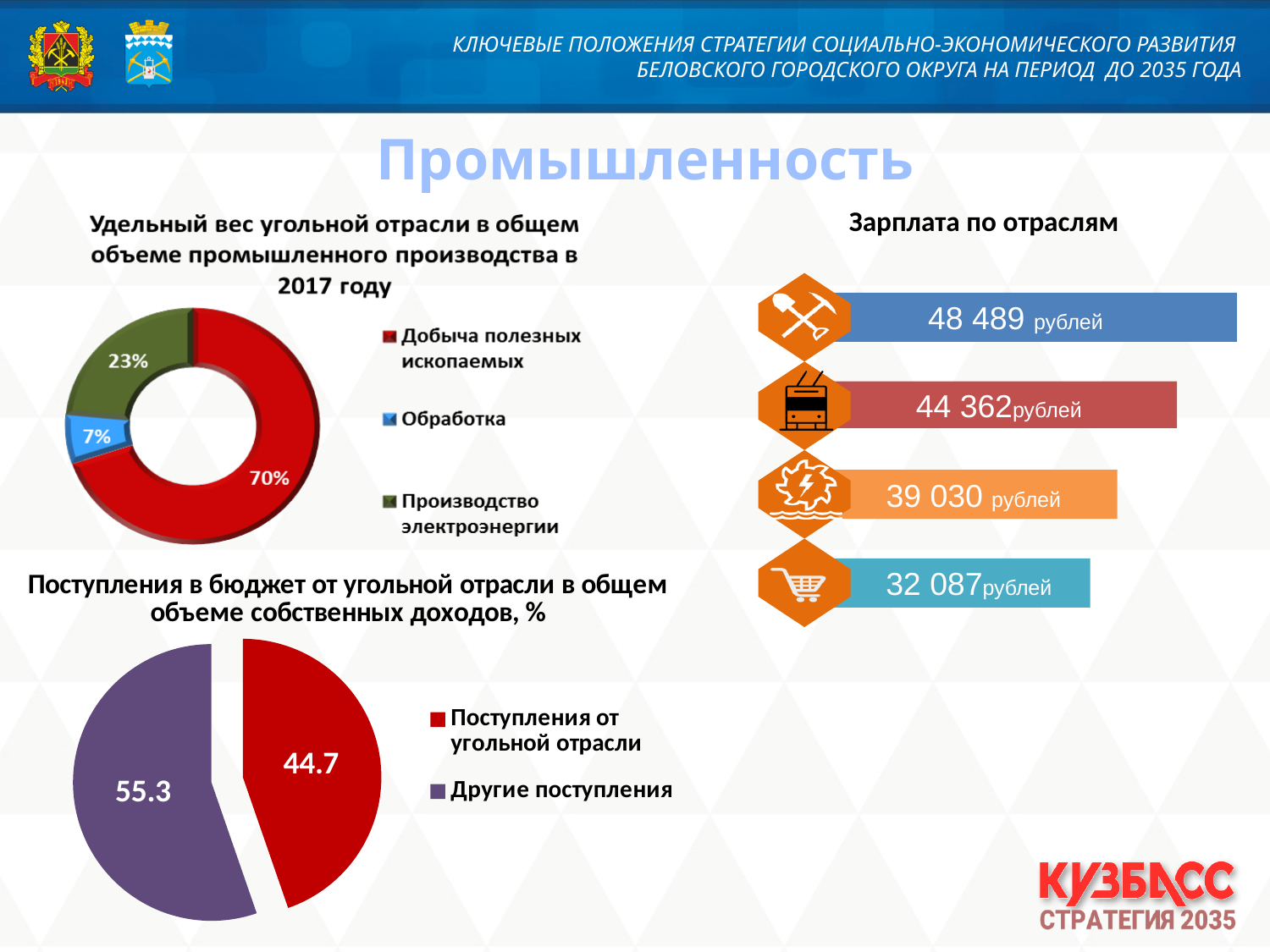
On the doughnut chart 'Удельный вес угольной отрасли в общем объеме промышленного производства в 2017 году', what is the share for 'Обработка'? 7% On the doughnut chart 'Удельный вес угольной отрасли в общем объеме промышленного производства в 2017 году', how many categories are shown? 3 On the doughnut chart 'Удельный вес угольной отрасли в общем объеме промышленного производства в 2017 году', which category has the largest share? Добыча полезных ископаемых On the pie chart 'Поступления в бюджет от угольной отрасли в общем объеме собственных доходов, %', what is the value for 'Другие поступления'? 55.3 On the doughnut chart 'Удельный вес угольной отрасли в общем объеме промышленного производства в 2017 году', which category has the smallest share? Обработка On the doughnut chart 'Удельный вес угольной отрасли в общем объеме промышленного производства в 2017 году', what is the difference in percentage points between 'Производство электроэнергии' and 'Обработка'? 16 On the pie chart 'Поступления в бюджет от угольной отрасли в общем объеме собственных доходов, %', what is the value for 'Поступления от угольной отрасли'? 44.7 On the doughnut chart 'Удельный вес угольной отрасли в общем объеме промышленного производства в 2017 году', what is the share for 'Производство электроэнергии'? 23% On the pie chart 'Поступления в бюджет от угольной отрасли в общем объеме собственных доходов, %', which slice is larger: 'Поступления от угольной отрасли' or 'Другие поступления'? Другие поступления On the doughnut chart 'Удельный вес угольной отрасли в общем объеме промышленного производства в 2017 году', what is the share for 'Добыча полезных ископаемых'? 70% On the pie chart 'Поступления в бюджет от угольной отрасли в общем объеме собственных доходов, %', what is the difference between 'Другие поступления' and 'Поступления от угольной отрасли'? 10.6 What type of chart is the bottom-left chart 'Поступления в бюджет от угольной отрасли в общем объеме собственных доходов, %'? Pie chart